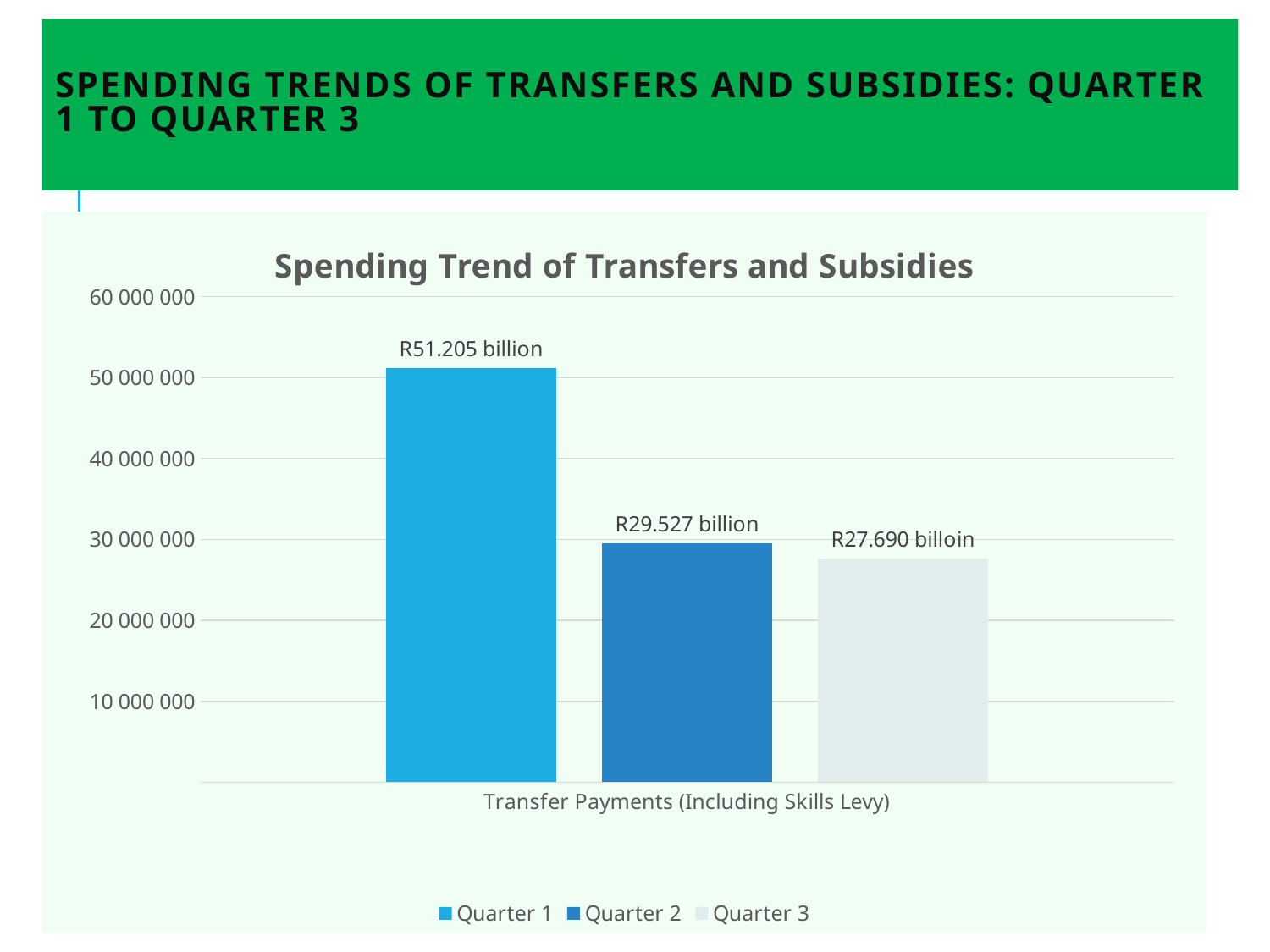
How many series does the legend list? 3 What is the value for Quarter 2 in the chart? R29.527 billion What is the value labelled on the Quarter 3 bar? R27.690 billoin What is the difference between the Quarter 1 and Quarter 2 values? R21.678 billion Which quarter has the lowest spending on transfers and subsidies? Quarter 3 Which quarter has the highest spending on transfers and subsidies? Quarter 1 What kind of chart is shown on the slide? Bar chart Which is larger, the value for Quarter 1 or the value for Quarter 2? Quarter 1 What is the value for Quarter 1 in the Spending Trend of Transfers and Subsidies chart? R51.205 billion Do the values rise or fall from Quarter 1 to Quarter 3? Fall What is the difference between the Quarter 2 and Quarter 3 values? R1.837 billion Is the value for Quarter 2 greater or less than 30 000 000 on the axis? less